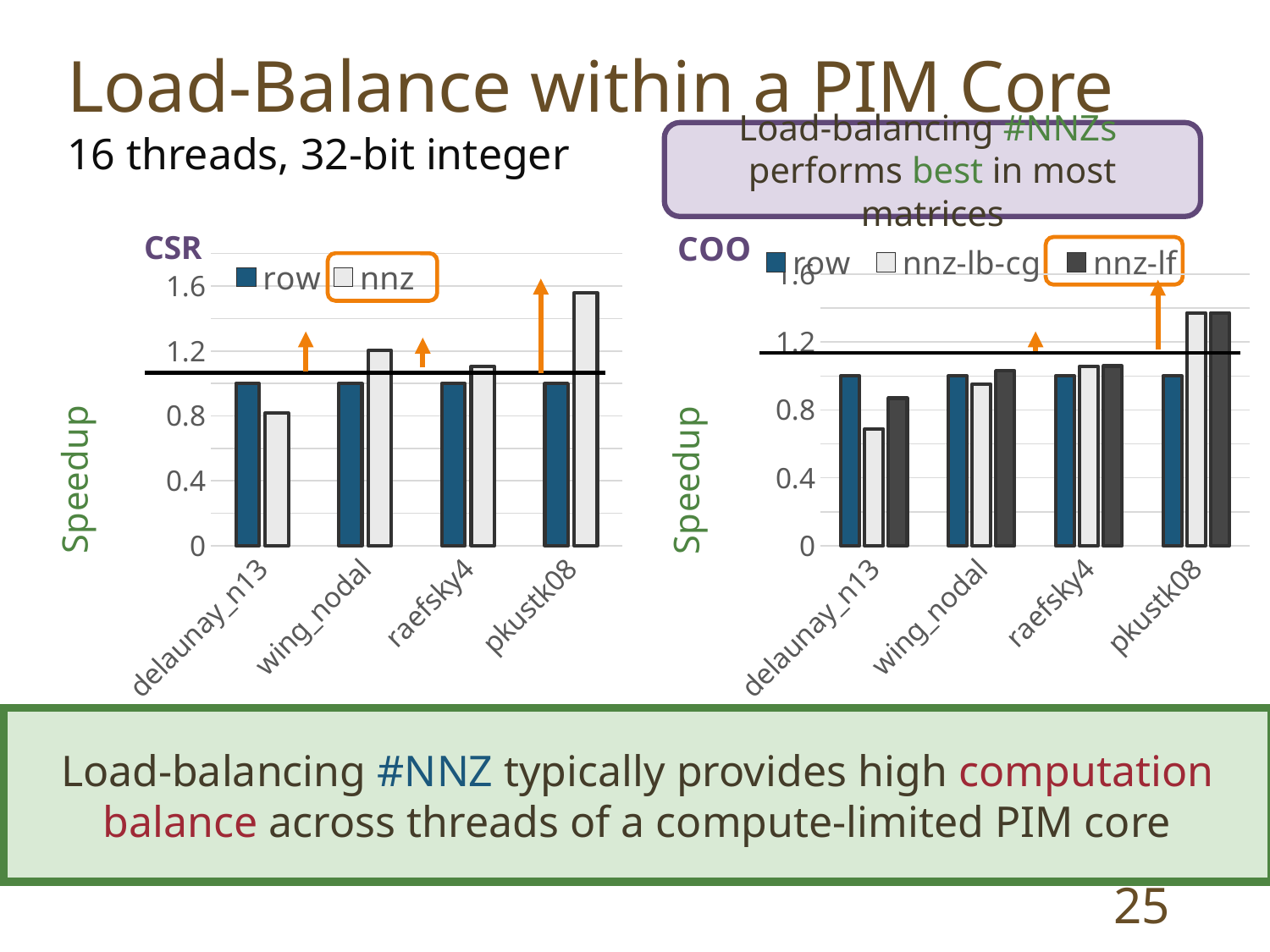
In the CSR chart, which matrix has the highest nnz speedup? pkustk08 In the CSR chart, which matrix has the lowest nnz speedup? delaunay_n13 In the COO chart, which matrix has the highest nnz-lf speedup? pkustk08 In the CSR chart, for delaunay_n13, which is larger: the row bar or the nnz bar? row What is the y-axis label of the COO chart? Speedup In the CSR chart, is the nnz speedup for delaunay_n13 greater or less than 1.2? less How many series does the legend of the CSR chart list? 2 In the COO chart, is the nnz-lb-cg speedup for delaunay_n13 greater or less than 0.8? less How many series does the legend of the COO chart list? 3 How many matrices (categories) are shown on the x axis of the CSR chart? 4 In the CSR chart, is the nnz speedup for pkustk08 greater or less than 1.2? greater What kind of chart is the CSR chart on the left? bar chart